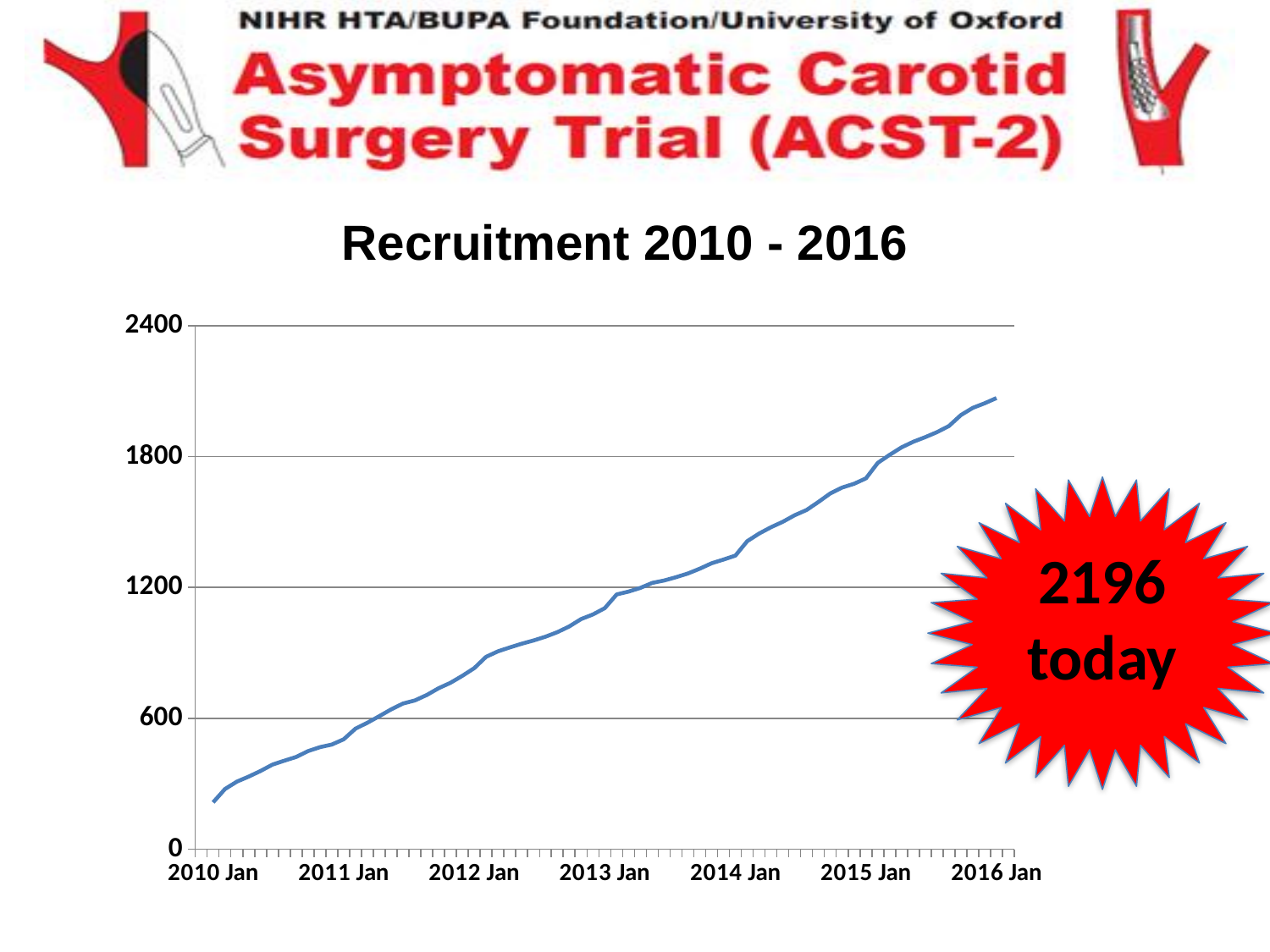
Does the recruitment line rise or fall from 2010 Jan to 2016 Jan? rise Is the value at 2011 Jan greater or less than 600? less Which is larger, the value at 2013 Jan or the value at 2015 Jan? 2015 Jan What kind of chart is shown on the slide? line chart At which labelled date on the x axis is the recruitment value highest? 2016 Jan What is the title of the chart? Recruitment 2010 - 2016 Is the value at 2015 Jan greater or less than 1800? less Is the value at 2012 Jan greater or less than 600? greater How many year labels are shown on the x axis? 7